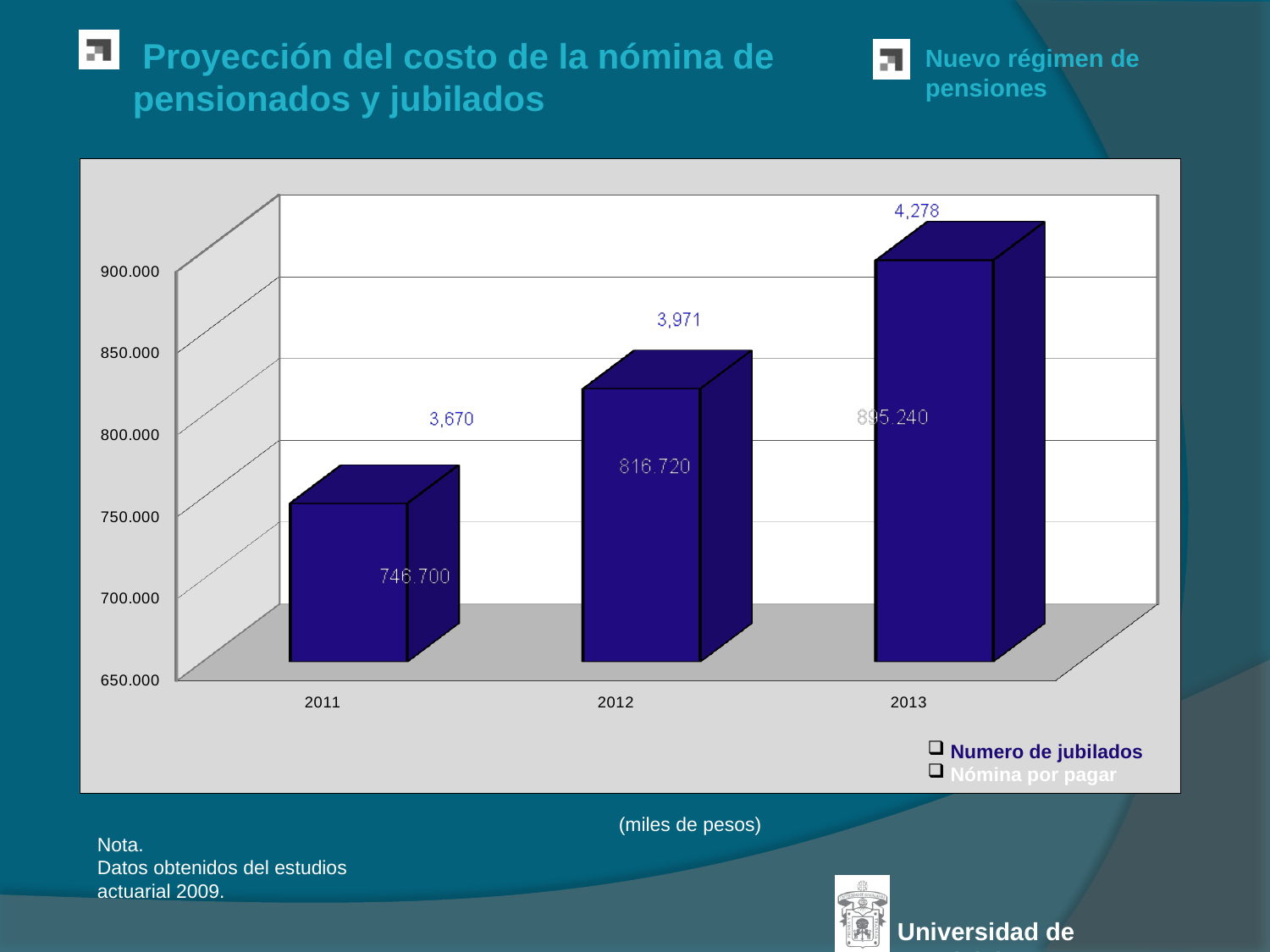
Which year has the lowest Numero de jubilados? 2011 What is the Nómina por pagar value for 2012? 816.720 What is the Numero de jubilados for 2011? 3,670 What is the Nómina por pagar value for 2011? 746.700 How many series does the legend list? 2 Does the Nómina por pagar rise or fall from 2011 to 2013? rise What is the difference in Nómina por pagar between 2012 and 2011? 70.020 What is the difference in Numero de jubilados between 2013 and 2011? 608 How many years are shown on the x axis of the chart? 3 What is the Numero de jubilados for 2013? 4,278 Is the Nómina por pagar for 2011 greater or less than 800.000? less Which year has the highest Nómina por pagar? 2013